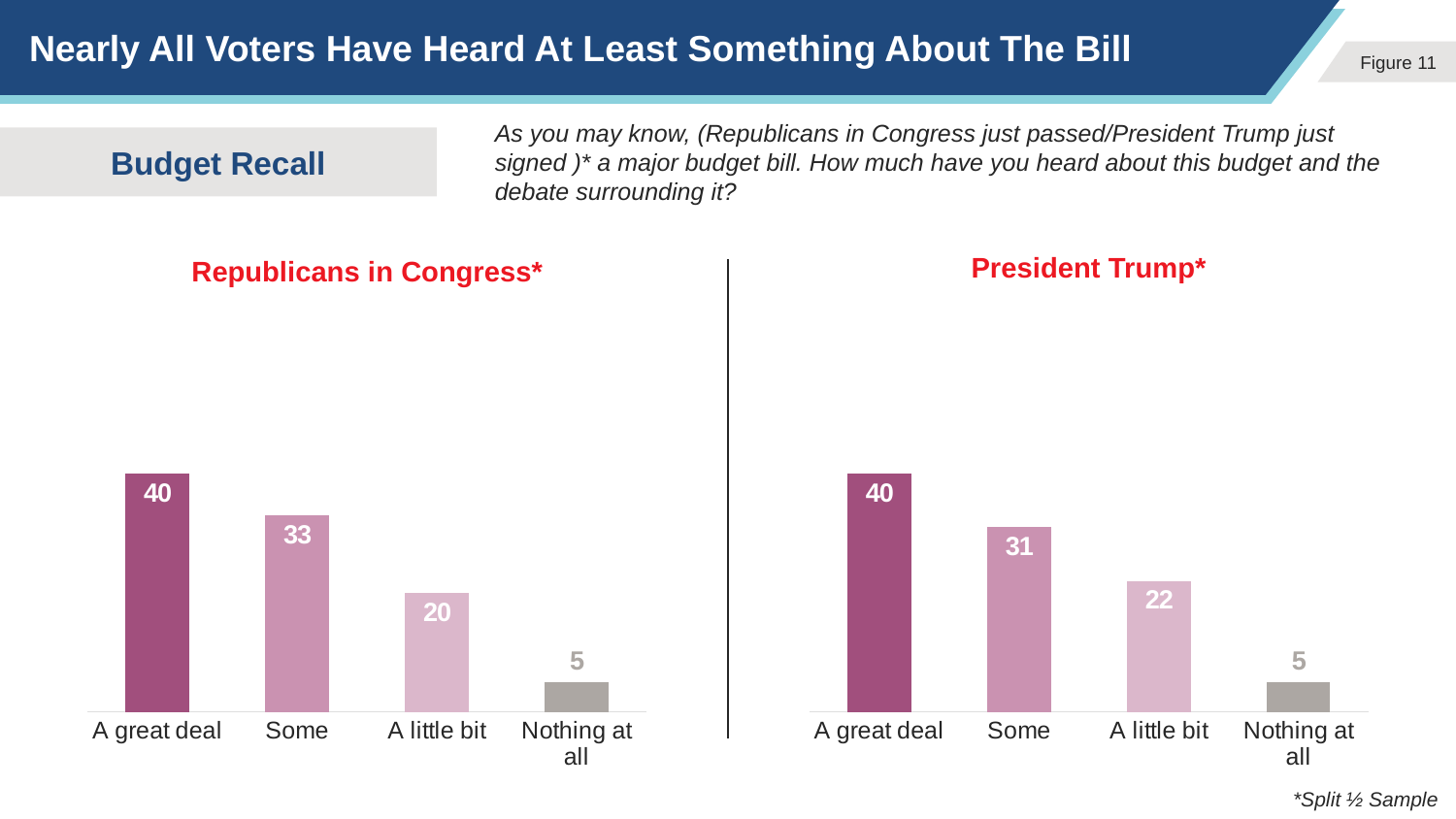
In the 'President Trump*' chart, what is the difference between 'A great deal' and 'Nothing at all'? 35 In the 'Republicans in Congress*' chart, what is the value for 'A great deal'? 40 What kind of chart is the 'President Trump*' chart? Bar chart In the 'Republicans in Congress*' chart, which category has the highest value? A great deal In the 'Republicans in Congress*' chart, how many categories are shown? 4 In the 'President Trump*' chart, which category has the lowest value? Nothing at all In the 'President Trump*' chart, what is the value for 'Some'? 31 In the 'President Trump*' chart, do the values rise or fall from left to right? Fall Which is larger: 'Some' in the 'Republicans in Congress*' chart or 'Some' in the 'President Trump*' chart? Republicans in Congress* In the 'Republicans in Congress*' chart, what is the difference between 'Some' and 'A little bit'? 13 What is the title of the chart on the left side of the slide? Republicans in Congress* In the 'President Trump*' chart, what is the value for 'A little bit'? 22